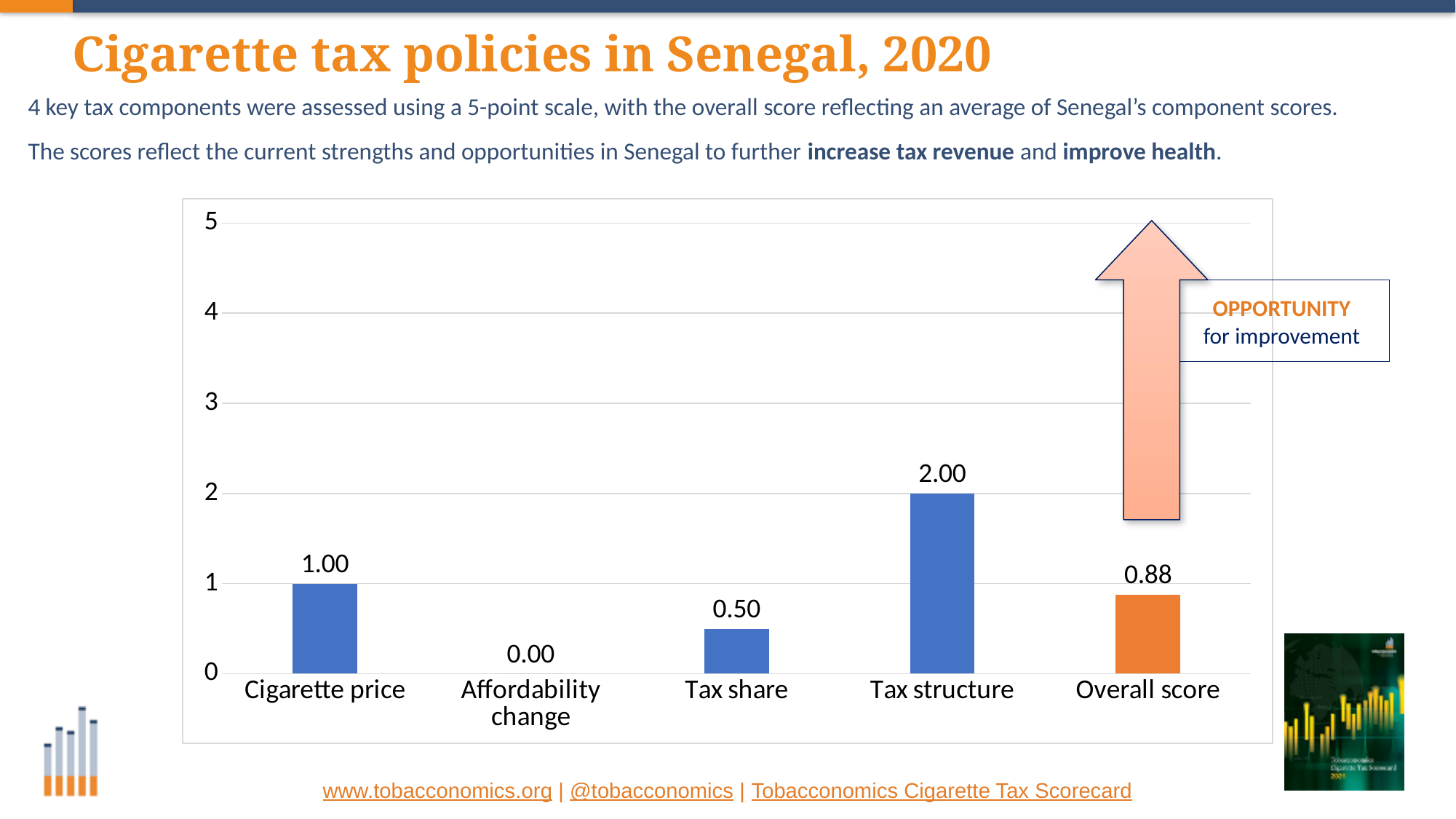
What is the value for Affordability change? 0.00 What is the value for Tax share? 0.50 What is the value for Cigarette price? 1.00 How many categories are shown on the x axis? 5 What is the value for Tax structure? 2.00 Which category has the highest value? Tax structure What is the difference between the values for Tax structure and Cigarette price? 1.00 What kind of chart is shown on the slide? bar chart Which category has the lowest value? Affordability change Which is larger, the value for Cigarette price or the value for Overall score? Cigarette price Is the value for Tax structure greater or less than 3? less What is the Overall score? 0.88